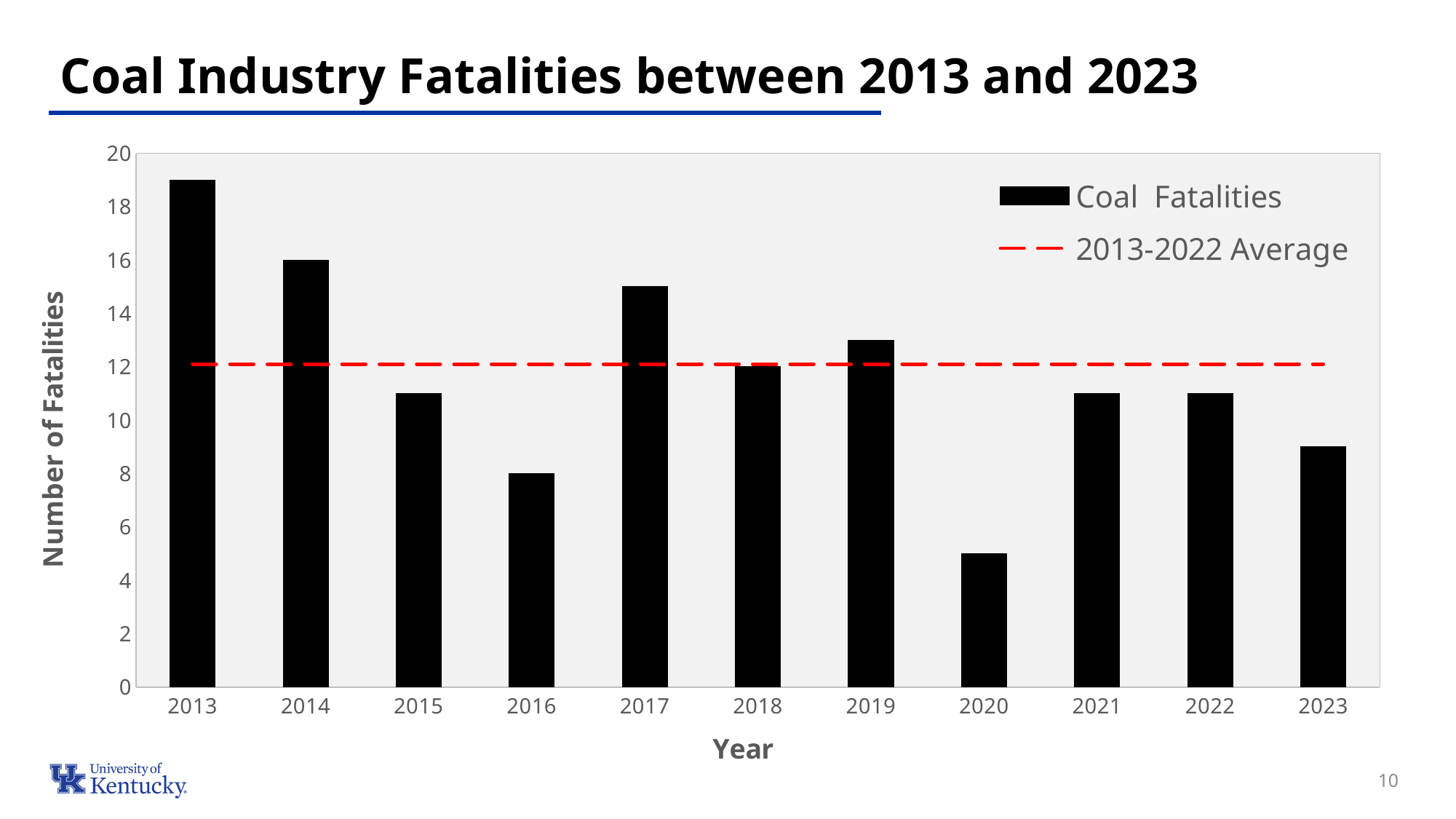
What kind of chart is shown on the slide? bar chart What is the difference between the coal fatalities in 2014 and 2016? 8 How many years are plotted on the x axis? 11 Is the value for 2020 greater or less than 6? less Which year has the highest number of coal fatalities? 2013 How many entries does the legend list? 2 Which year has the lowest number of coal fatalities? 2020 What is the number of coal fatalities in 2018? 12 What is the number of coal fatalities in 2016? 8 What is the number of coal fatalities in 2014? 16 Which year has more coal fatalities, 2013 or 2023? 2013 Is the value for 2013 greater or less than 18? greater